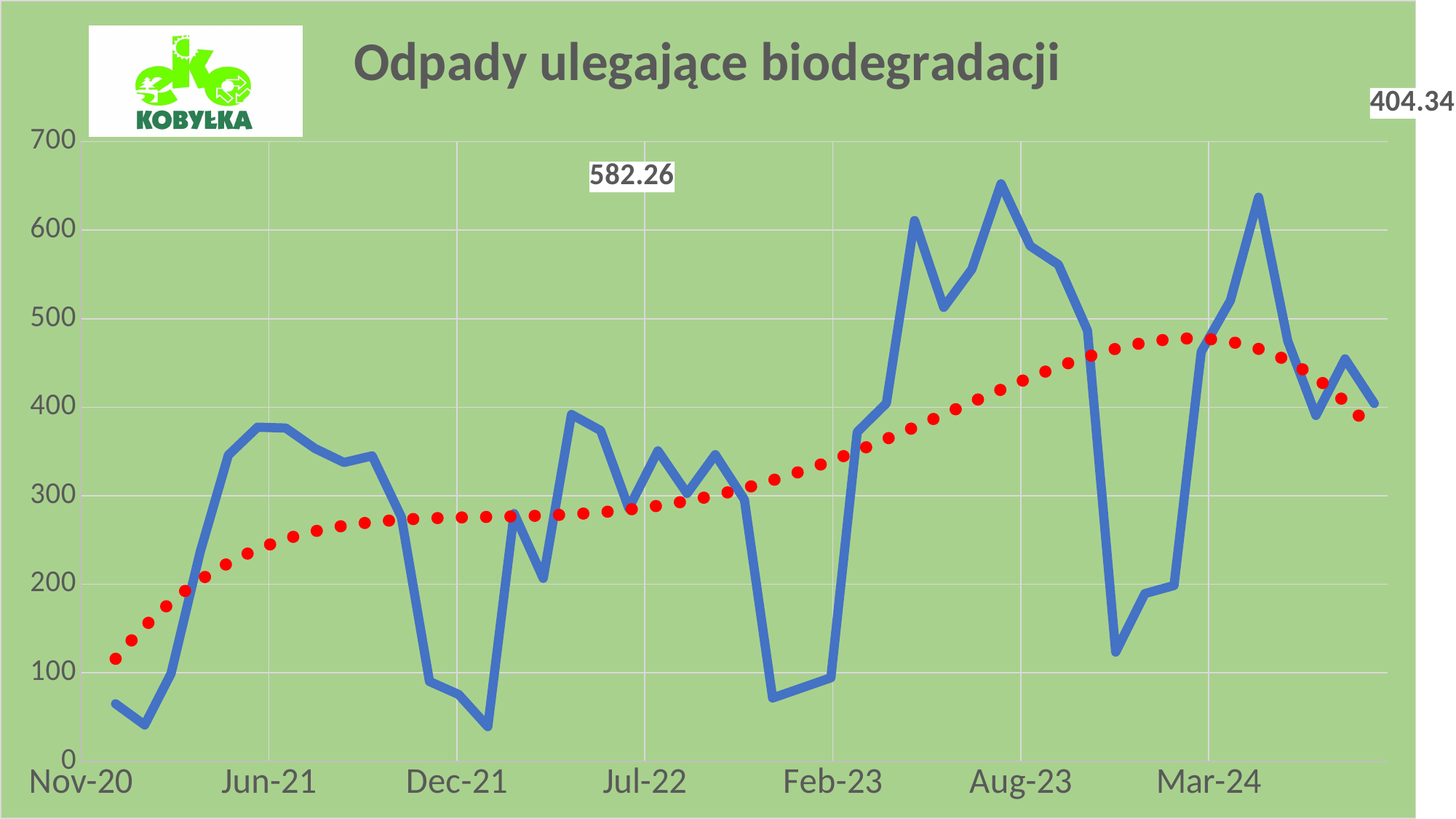
Is the value for Jun-21 greater or less than 300? greater Which has the larger value, Dec-21 or Aug-23? Aug-23 Is the value for Nov-20 greater or less than 100? less Is the value for Aug-23 greater or less than 600? greater Which has the larger value, Nov-20 or Jun-21? Jun-21 What is the title of the chart? Odpady ulegające biodegradacji How many date labels are shown on the x axis? 7 What colour is the dotted trend line? red Does the red dotted trend line generally rise or fall from left to right? rise What is the highest value shown on the y axis? 700 What kind of chart is shown on the slide? line chart